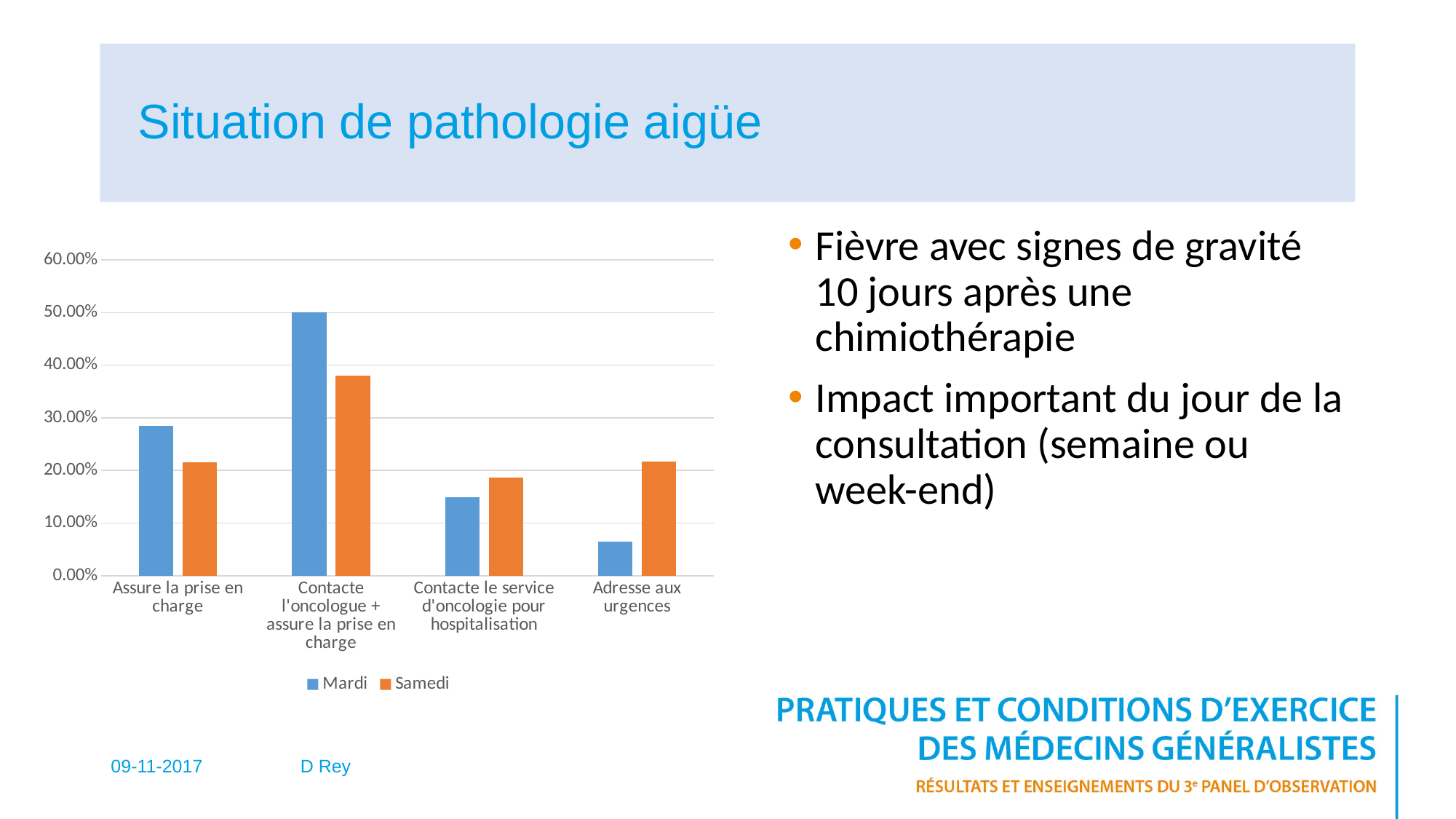
Is the Samedi value for 'Contacte l'oncologue + assure la prise en charge' greater or less than 30.00%? greater Which category has the highest value for the Mardi series? Contacte l'oncologue + assure la prise en charge Which category has the lowest value for the Mardi series? Adresse aux urgences What kind of chart is shown on the slide? Bar chart For 'Adresse aux urgences', which series has the larger value, Mardi or Samedi? Samedi How many series does the chart legend list? 2 Which category has the highest value for the Samedi series? Contacte l'oncologue + assure la prise en charge What are the two series names listed in the chart legend? Mardi and Samedi Is the Mardi value for 'Adresse aux urgences' greater or less than 10.00%? less How many categories are shown on the x axis of the chart? 4 For 'Assure la prise en charge', which series has the larger value, Mardi or Samedi? Mardi